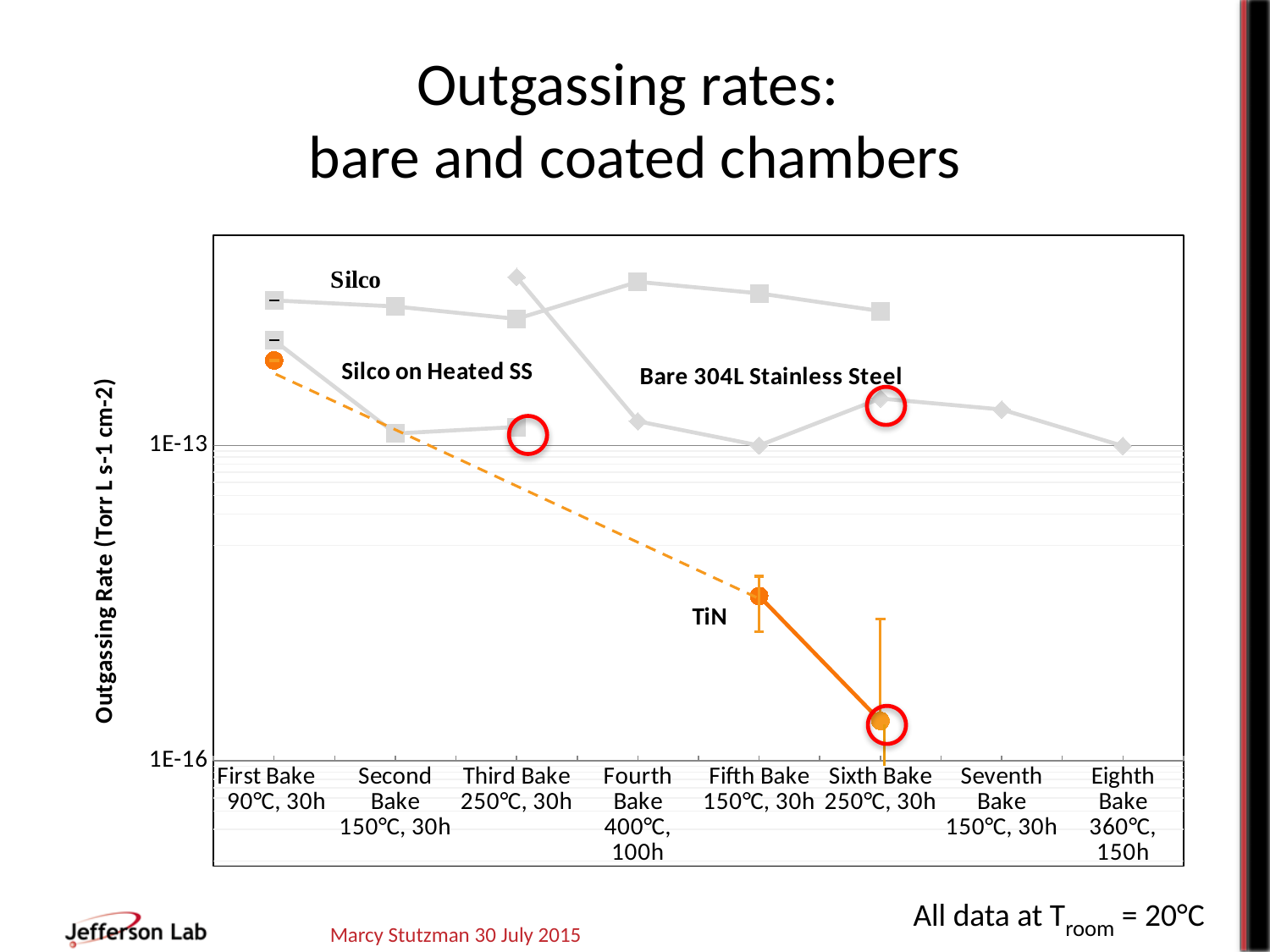
At Fifth Bake, which series has the higher value, Silco or TiN? Silco Which series has the lowest value at Sixth Bake? TiN At First Bake, which is higher, Silco or Silco on Heated SS? Silco Does the TiN series rise or fall from First Bake to Sixth Bake? fall Is the Silco value at First Bake greater or less than 1E-13? greater What type of chart is shown on the slide? line chart What is the label of the y axis? Outgassing Rate (Torr L s-1 cm-2) Is the TiN value at Fifth Bake greater or less than 1E-13? less At which bake does the TiN series reach its lowest value? Sixth Bake How many data series are labeled on the chart? 4 How many bake steps are listed along the x axis? 8 Is the TiN value at Sixth Bake greater or less than 1E-13? less